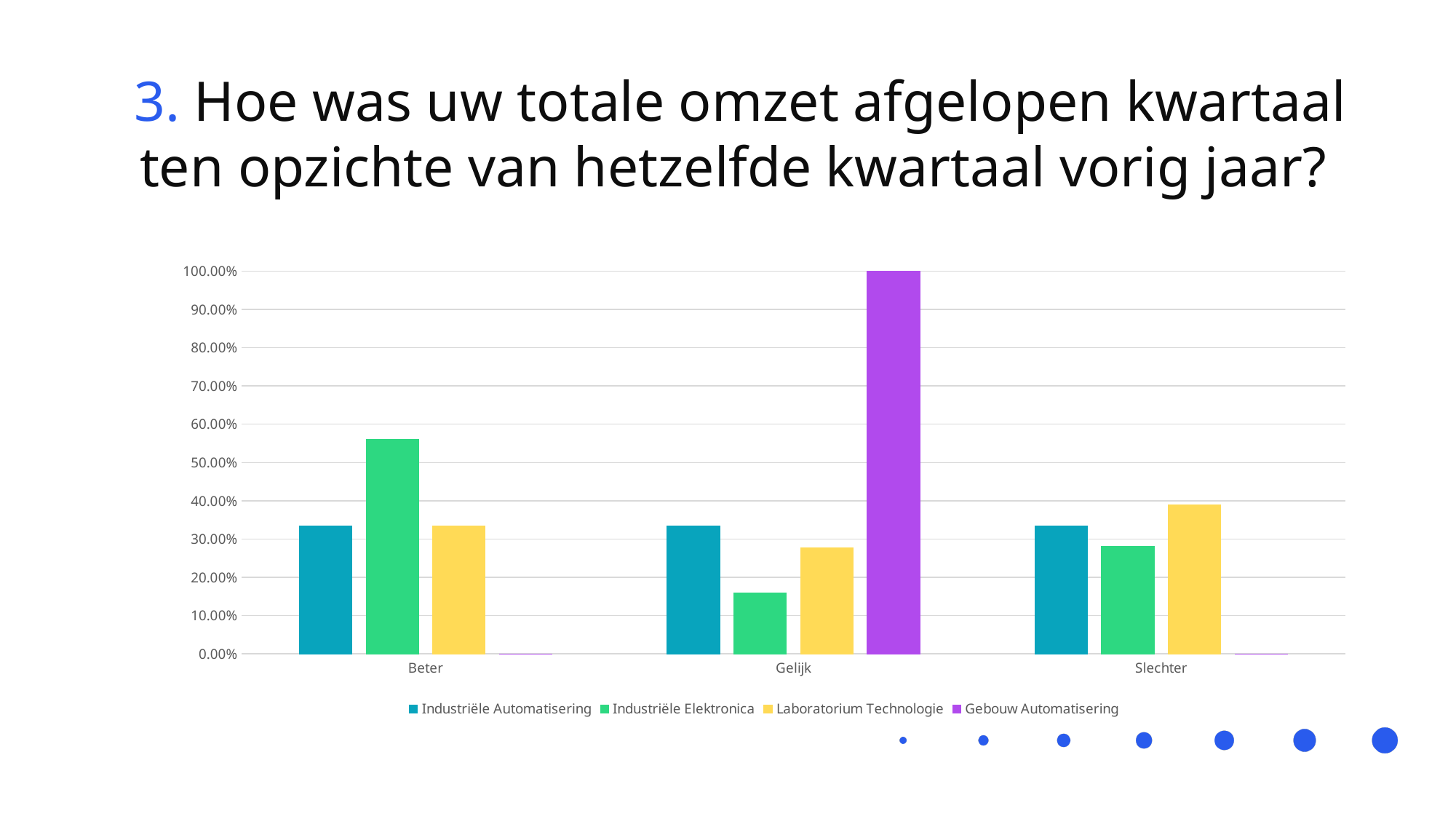
Which series has the lowest value in the Beter category? Gebouw Automatisering Which series has the highest value in the Slechter category? Laboratorium Technologie How many categories are shown on the x axis? 3 In the Gelijk category, which is larger: Industriële Automatisering or Industriële Elektronica? Industriële Automatisering Is the value for Industriële Elektronica in the Gelijk category greater or less than 20.00%? less Which series has the highest value in the Beter category? Industriële Elektronica What kind of chart is shown on the slide? bar chart How many series does the legend list? 4 What is the value for Gebouw Automatisering in the Gelijk category? 100.00% Which series has the highest value in the Gelijk category? Gebouw Automatisering Is the value for Laboratorium Technologie in the Slechter category greater or less than 30.00%? greater Is the value for Industriële Elektronica in the Beter category greater or less than 50.00%? greater